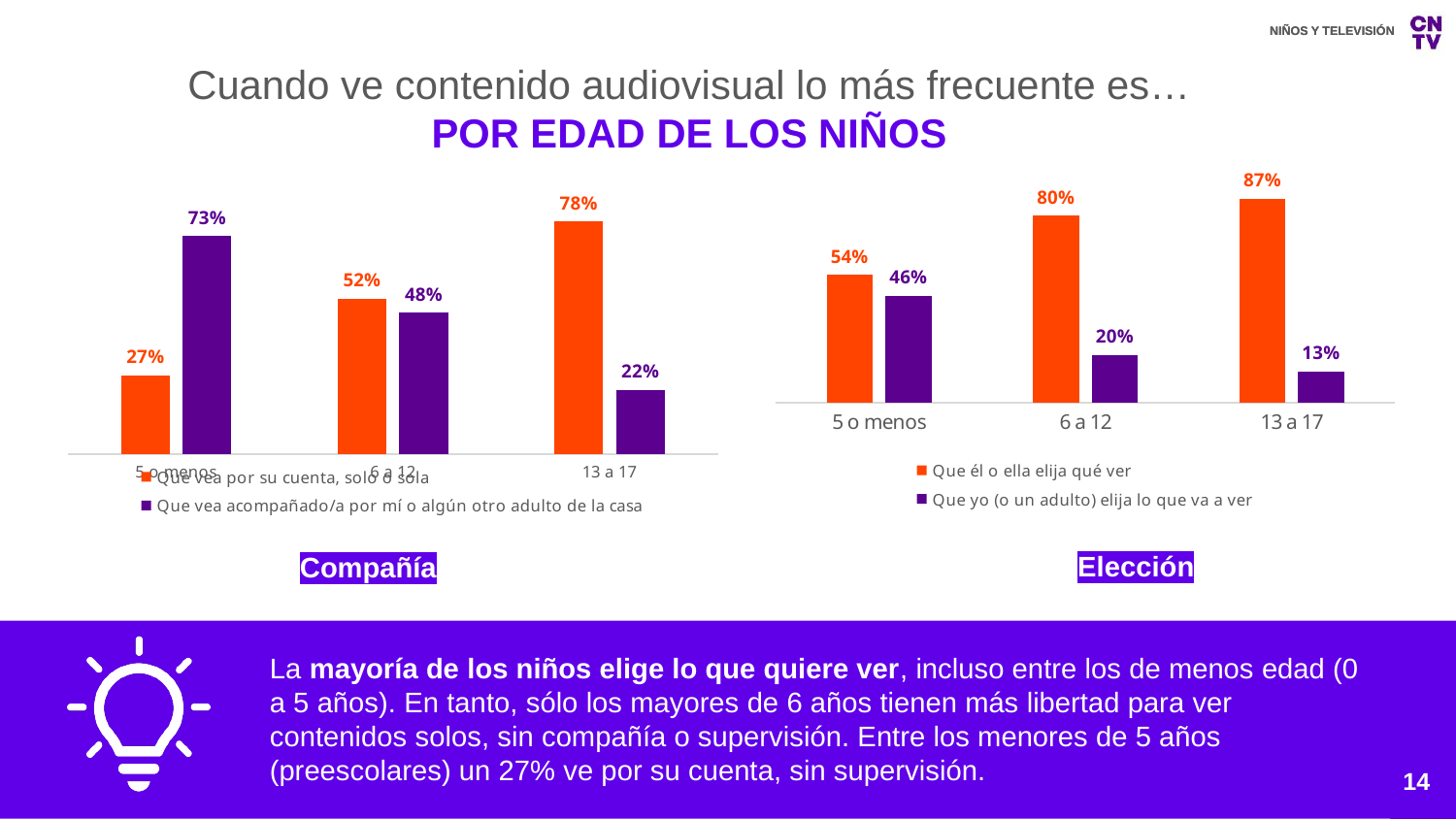
In the Elección chart, what is the value for 'Que él o ella elija qué ver' for the 13 a 17 age group? 87% How many age groups are shown on the x axis of the Elección chart? 3 In the Compañía chart, what percentage of children aged 5 o menos watch on their own (Que vea por su cuenta, solo o sola)? 27% In the Compañía chart, for the 5 o menos age group, which is larger: watching alone or watching accompanied by an adult? Watching accompanied by an adult (73%) In the Elección chart, does the value for 'Que él o ella elija qué ver' rise or fall as the age group increases? Rises In the Compañía chart, what is the difference between the two series for the 13 a 17 age group? 56 percentage points In the Compañía chart, what is the value for 'Que vea acompañado/a por mí o algún otro adulto de la casa' for the 6 a 12 age group? 48% In the Elección chart, what is the difference between 'Que él o ella elija qué ver' and 'Que yo (o un adulto) elija lo que va a ver' for the 6 a 12 age group? 60 percentage points In the Elección chart, what is the value for 'Que yo (o un adulto) elija lo que va a ver' for the 5 o menos age group? 46% In the Elección chart, which age group has the lowest value for 'Que yo (o un adulto) elija lo que va a ver'? 13 a 17 In the Compañía chart, which age group has the highest value for 'Que vea por su cuenta, solo o sola'? 13 a 17 What type of chart is the Compañía chart? Bar chart